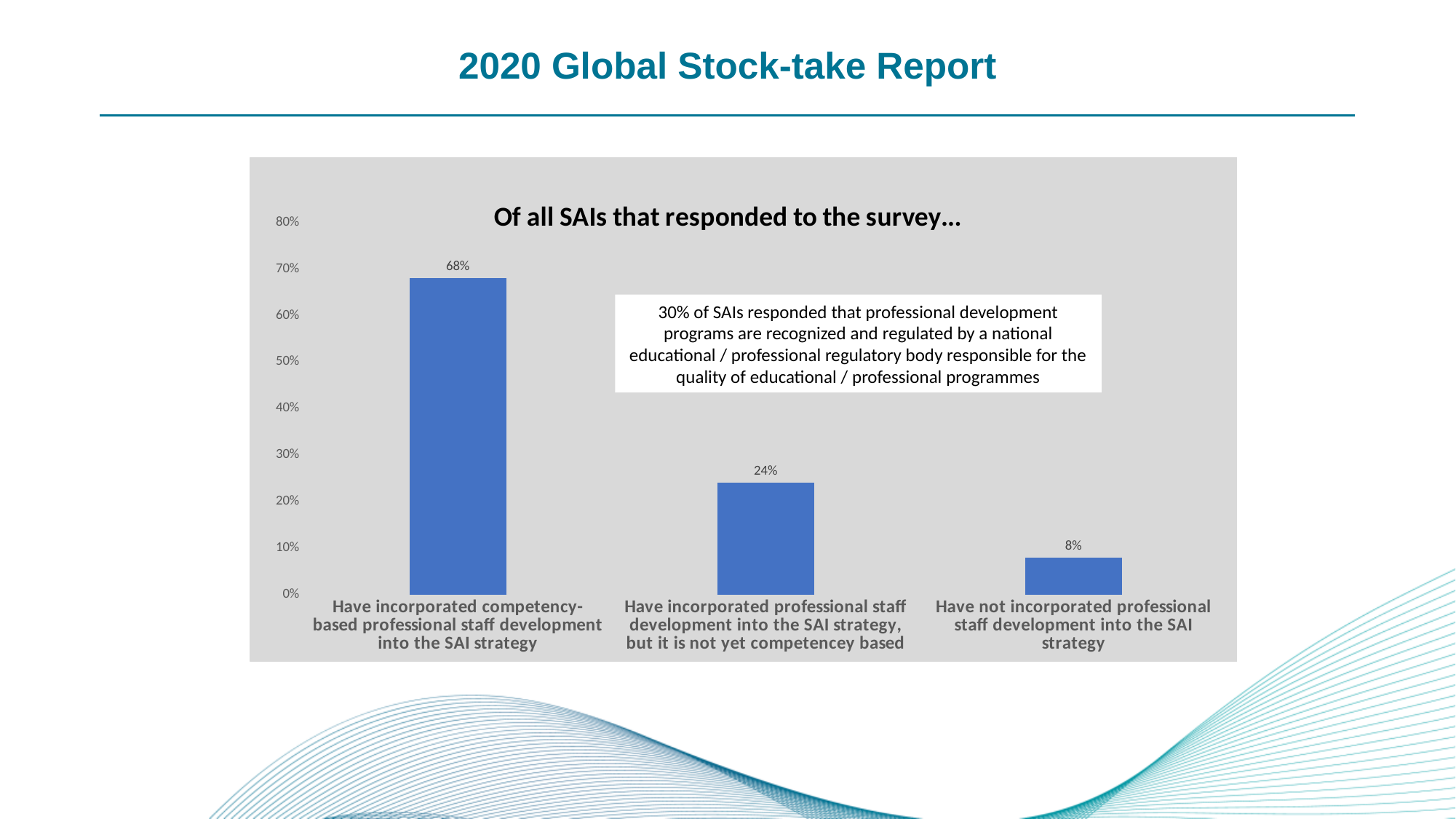
What kind of chart is shown on the slide? Bar chart What is the difference between the value for SAIs that have incorporated competency-based professional staff development and those that have incorporated it but not yet competency based? 44% What is the title of the chart? Of all SAIs that responded to the survey... What percentage of SAIs have incorporated professional staff development into the SAI strategy, but it is not yet competency based? 24% How many categories are shown in the chart? 3 Is the value for SAIs that have incorporated competency-based professional staff development greater or less than 60%? greater Which category has the lowest value in the chart? Have not incorporated professional staff development into the SAI strategy Which is larger: the value for SAIs that have incorporated professional staff development but not yet competency based, or the value for SAIs that have not incorporated it? Have incorporated professional staff development into the SAI strategy, but it is not yet competencey based What is the difference between the value for SAIs that have incorporated professional staff development but not yet competency based and those that have not incorporated it? 16% What percentage of SAIs have incorporated competency-based professional staff development into the SAI strategy? 68% What percentage of SAIs have not incorporated professional staff development into the SAI strategy? 8% Which category has the highest value in the chart? Have incorporated competency-based professional staff development into the SAI strategy